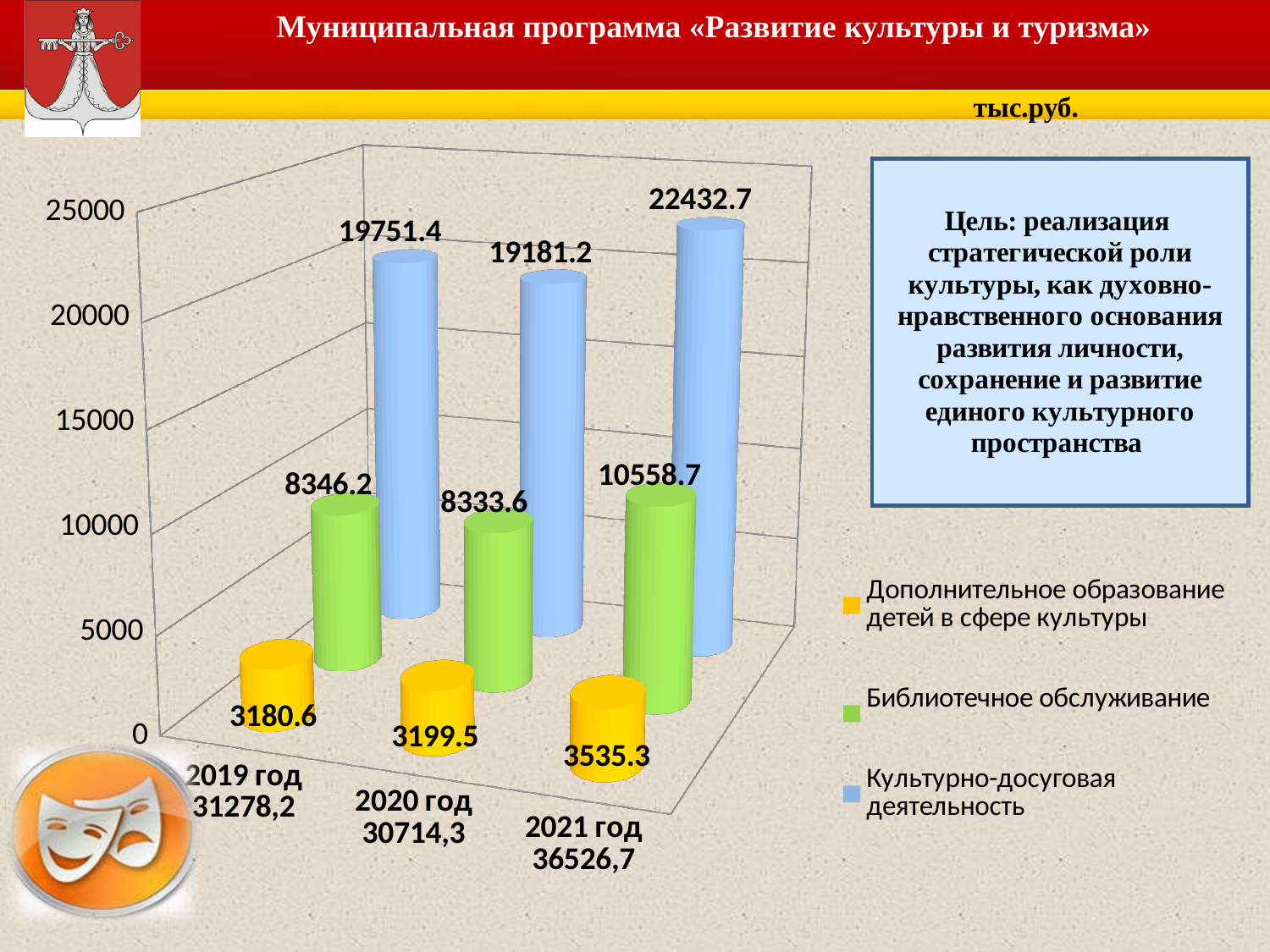
How many years (categories) are shown on the x axis? 3 In which year is the value for Дополнительное образование детей в сфере культуры the lowest? 2019 год In which year is the value for Культурно-досуговая деятельность the highest? 2021 год What kind of chart is shown on the slide? Bar chart Which colour represents Библиотечное обслуживание in the legend? Green How many series does the legend list? 3 Is the value for Библиотечное обслуживание in 2021 год greater or less than 10000? greater Which is larger: Культурно-досуговая деятельность in 2019 год or in 2020 год? 2019 год What is the value for Культурно-досуговая деятельность in 2021 год? 22432.7 What is the value for Библиотечное обслуживание in 2020 год? 8333.6 What is the value for Дополнительное образование детей в сфере культуры in 2019 год? 3180.6 What is the difference between the Библиотечное обслуживание values for 2021 год and 2020 год? 2225.1